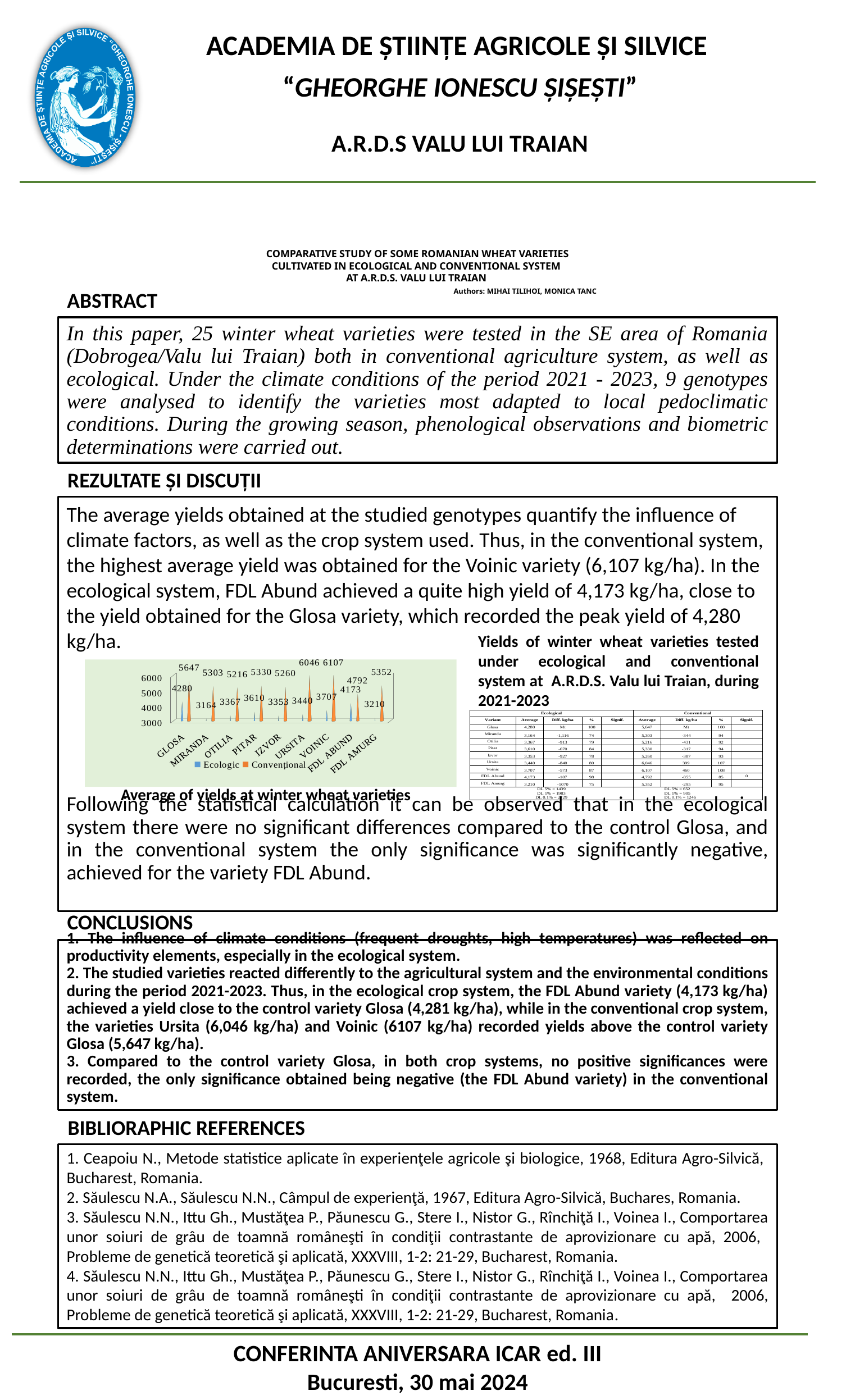
What type of chart is used to show the average yields? Bar chart What is the Conventional value for URSITA in the chart? 6046 Which is larger, the Ecologic value for PITAR or the Ecologic value for IZVOR? PITAR How many wheat varieties are shown on the x axis of the chart? 9 How many series does the chart legend list? 2 What is the Conventional value for VOINIC in the chart? 6107 What is the Ecologic value for GLOSA in the chart? 4280 Which variety has the lowest Ecologic value in the chart? MIRANDA What is the difference between the Conventional and Ecologic values for GLOSA? 1367 What is the Ecologic value for FDL ABUND in the chart? 4173 Which variety has the highest Conventional value in the chart? VOINIC Which variety has the lowest Conventional value in the chart? FDL ABUND